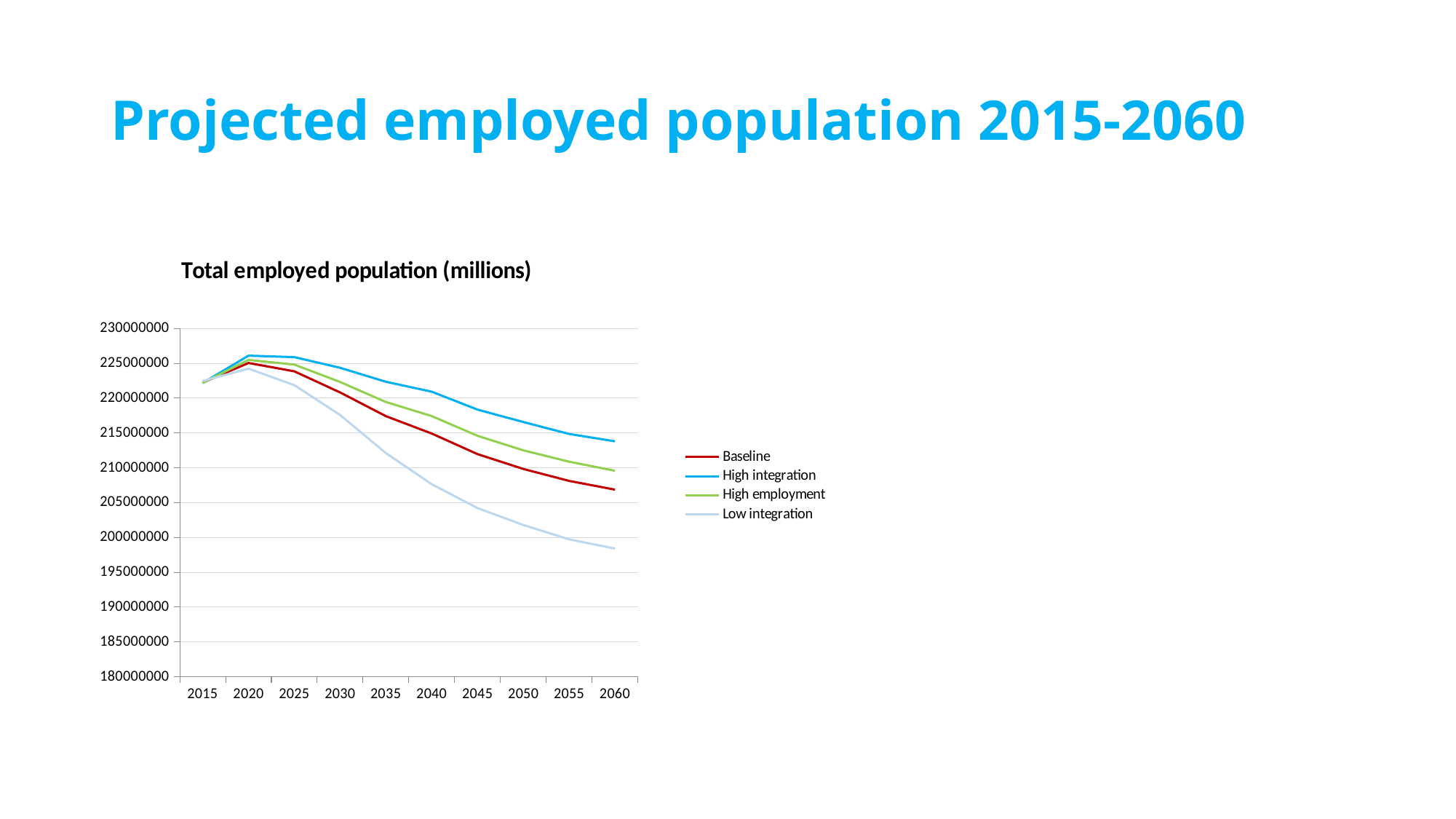
Which series has the lowest value in 2060? Low integration Is the value for Baseline in 2060 greater or less than 205000000? greater What is the title of the chart? Total employed population (millions) What kind of chart is shown on the slide? line chart Is the value for High integration in 2030 greater or less than 220000000? greater In 2050, which is larger: the Baseline value or the Low integration value? Baseline Which series has the highest value in 2060? High integration Is the value for Low integration in 2060 greater or less than 200000000? less How many series does the legend list? 4 How many years are plotted along the x axis? 10 Does the Low integration series rise or fall between 2020 and 2060? fall